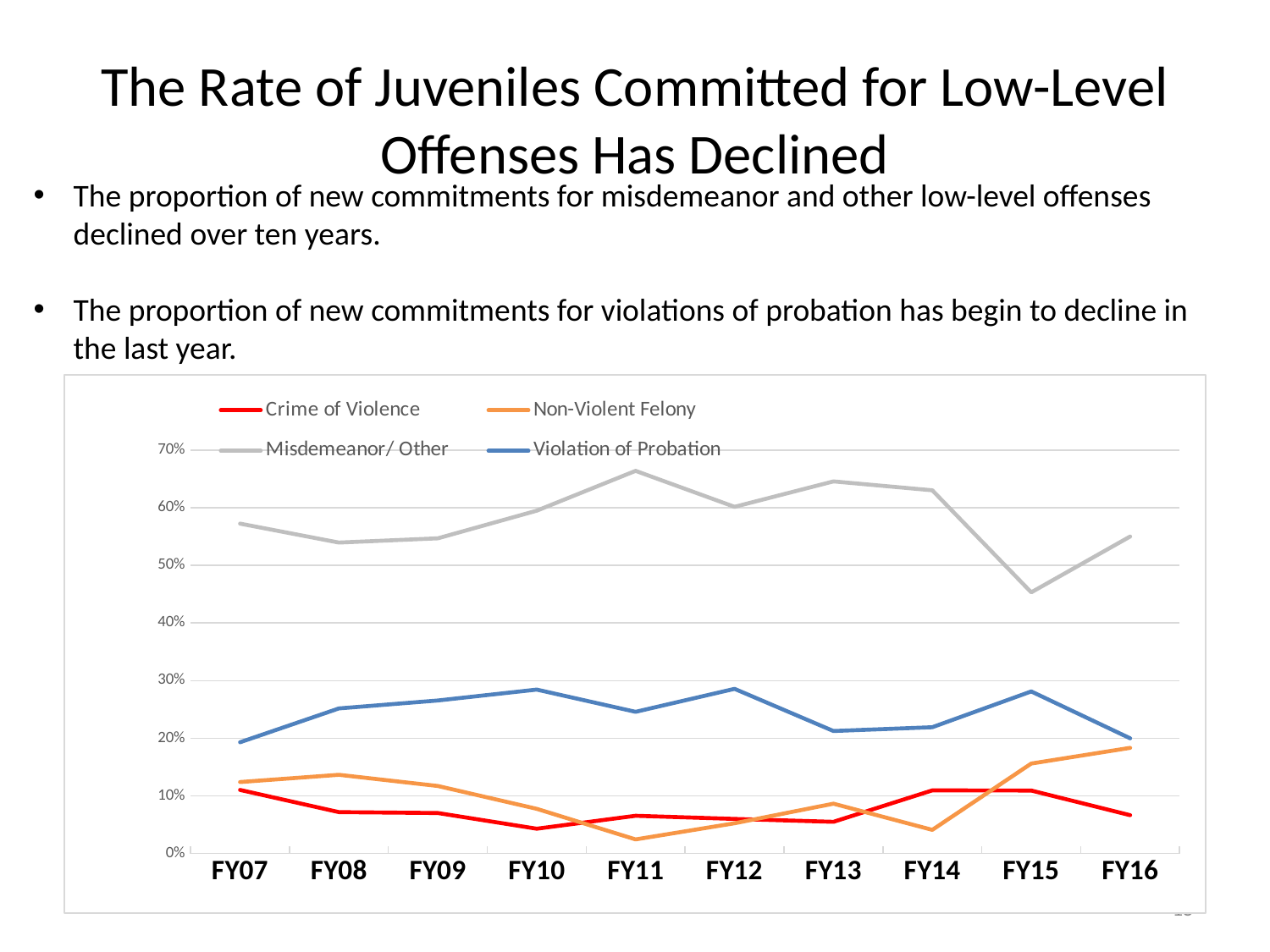
Is the value for Misdemeanor/ Other in FY07 greater or less than 50%? greater What colour is the Crime of Violence line in the chart? red In which fiscal year is the Misdemeanor/ Other line at its lowest? FY15 In FY16, which is larger: Non-Violent Felony or Crime of Violence? Non-Violent Felony Is the value for Violation of Probation in FY12 greater or less than 20%? greater Which series has the highest values across all years in the chart? Misdemeanor/ Other Does the Non-Violent Felony line rise or fall from FY14 to FY16? rise How many fiscal years are plotted along the x axis of the chart? 10 Is the value for Non-Violent Felony in FY11 greater or less than 10%? less What kind of chart is shown on the slide? line chart How many series does the chart's legend list? 4